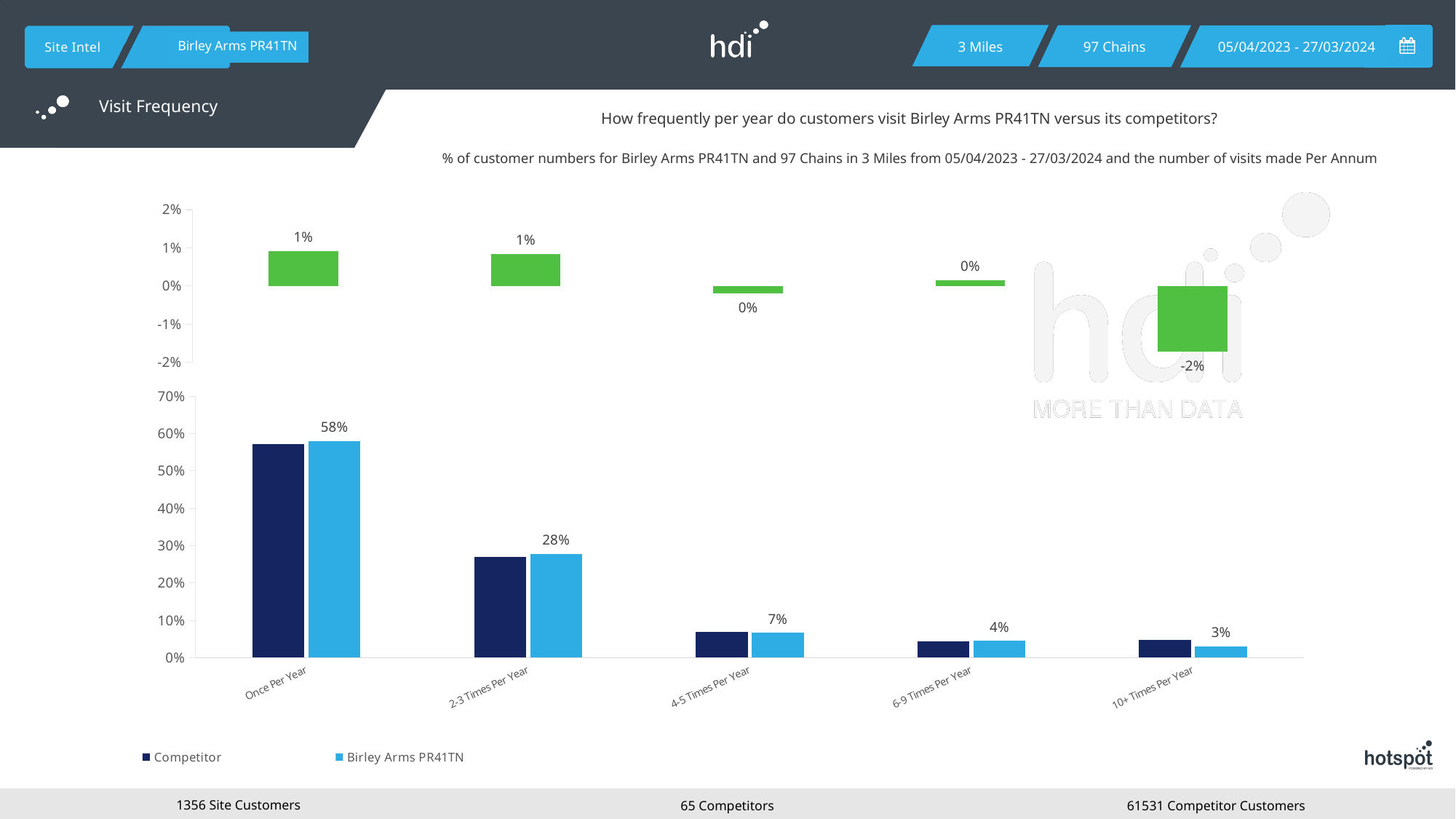
In the top chart, what is the value shown for the 10+ Times Per Year bar? -2% How many series does the legend of the bottom chart list? 2 What kind of chart is the bottom chart? bar chart In the bottom chart, which category has the lowest value for Birley Arms PR41TN? 10+ Times Per Year How many categories are shown on the x axis of the bottom chart? 5 In the bottom chart, is the Competitor value for Once Per Year greater or less than 50%? greater In the bottom chart, what is the value for Birley Arms PR41TN for 2-3 Times Per Year? 28% In the bottom chart, what is the value for Birley Arms PR41TN for Once Per Year? 58% In the bottom chart, what is the difference between the Birley Arms PR41TN values for Once Per Year and 2-3 Times Per Year? 30% In the bottom chart, which category has the highest value for Birley Arms PR41TN? Once Per Year In the bottom chart, what is the value for Birley Arms PR41TN for 10+ Times Per Year? 3% In the bottom chart, is the Competitor value for 4-5 Times Per Year greater or less than 10%? less